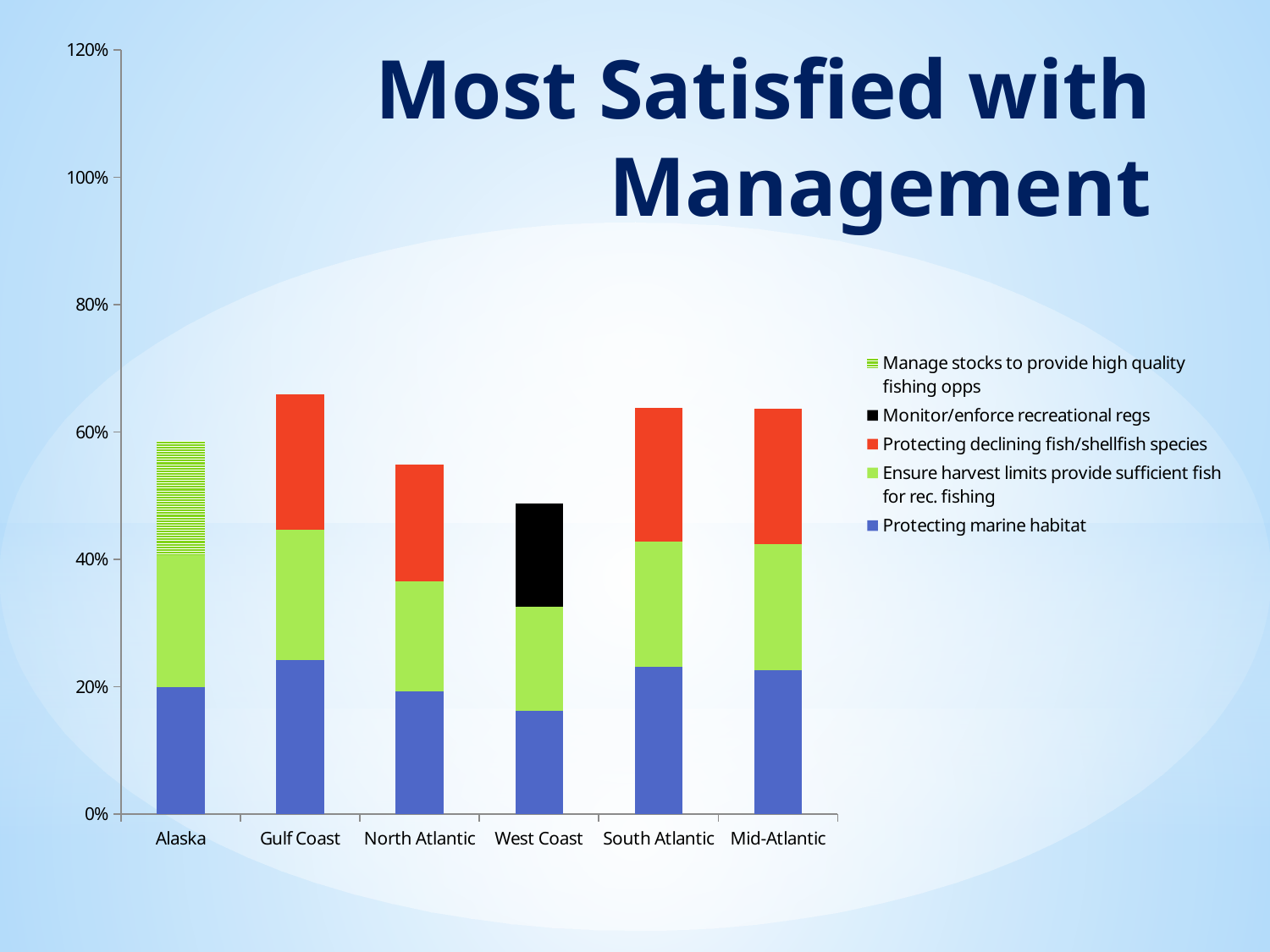
Is the total stacked bar for Gulf Coast greater or less than 60%? greater Which region has the lowest 'Protecting marine habitat' value? West Coast Is the total stacked bar for West Coast greater or less than 60%? less Which region's bar includes a 'Monitor/enforce recreational regs' segment? West Coast Is the 'Protecting marine habitat' value for West Coast greater or less than 20%? less What is the title of the slide containing the chart? Most Satisfied with Management Which has the larger total stacked bar, North Atlantic or West Coast? North Atlantic Which region has the lowest total stacked bar? West Coast How many regions are shown on the x axis of the chart? 6 Which region has the highest total stacked bar? Gulf Coast What kind of chart is shown on the slide? Stacked bar chart How many series does the chart's legend list? 5